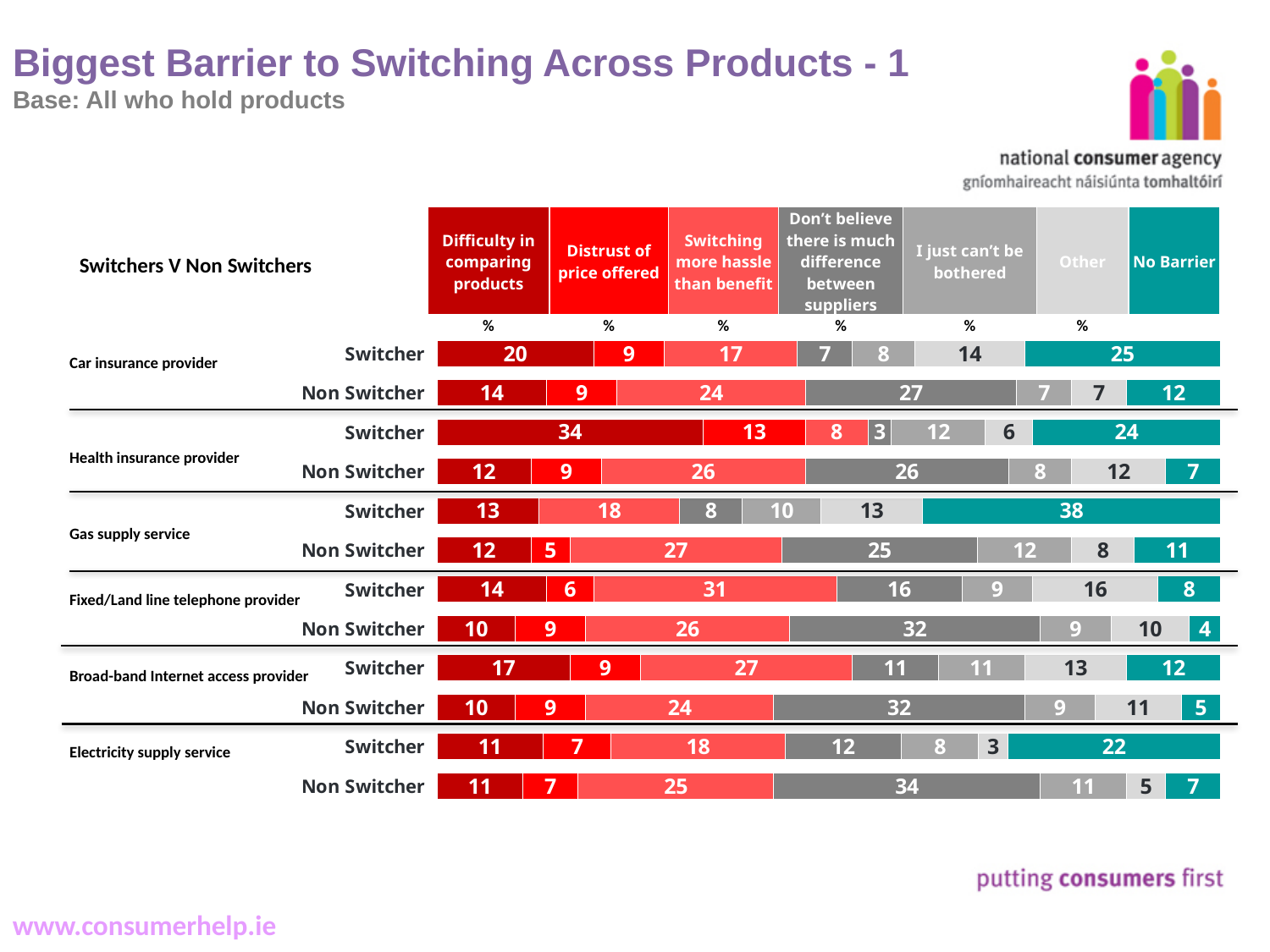
How many products are compared in the chart? 6 For car insurance provider, how much higher is the 'Switching more hassle than benefit' value for Non Switchers than for Switchers? 7 For broad-band Internet access provider, which group has the larger 'Don't believe there is much difference between suppliers' value, Switchers or Non Switchers? Non Switcher How many barrier categories (series) are shown in the chart header? 7 What is the total of the car insurance provider Switcher bar? 100 Among the Switcher bars, which product has the highest 'No Barrier' value? Gas supply service What percentage of car insurance provider Switchers cite 'Difficulty in comparing products' as the biggest barrier? 20 What is the 'Difficulty in comparing products' value for health insurance provider Switchers? 34 What is the 'Switching more hassle than benefit' value for fixed/land line telephone provider Switchers? 31 What is the 'No Barrier' value for gas supply service Switchers? 38 What is the 'Don't believe there is much difference between suppliers' value for electricity supply service Non Switchers? 34 What type of chart is shown on the slide? Stacked bar chart